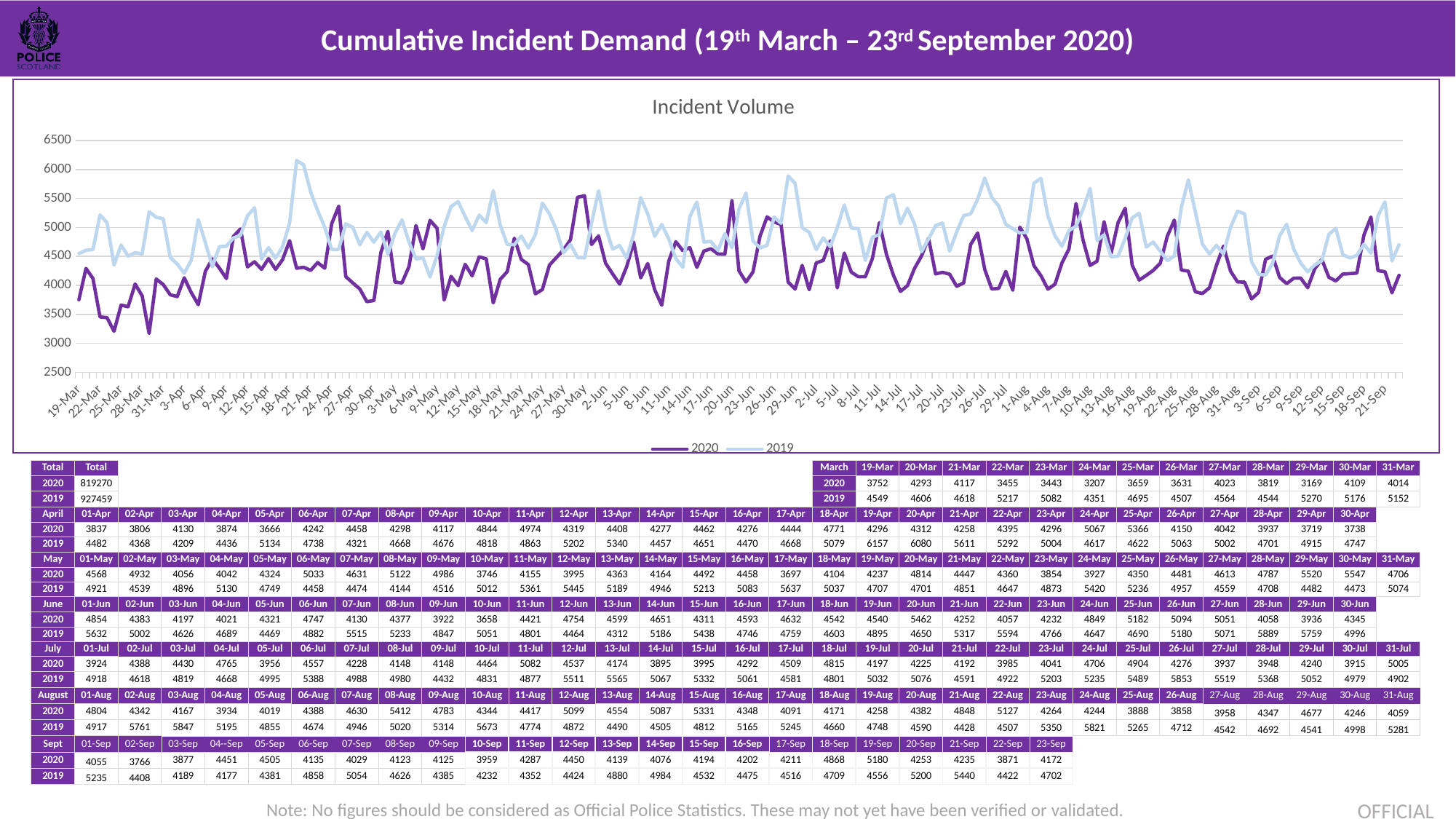
What is the 2020 incident volume on 19-Mar? 3752 Is the 2019 value on 19-Apr greater or less than 6000? greater What is the total incident volume for 2020? 819270 On 30-May, which series has the larger value, 2020 or 2019? 2020 What is the title of the chart? Incident Volume What is the difference between the 2019 value (4702) and the 2020 value (4172) on 23-Sep? 530 What is the difference between the 2019 total (927459) and the 2020 total (819270)? 108189 Is the 2020 value on 19-Mar greater or less than 4000? less What is the 2019 incident volume on 19-Apr? 6157 What kind of chart is shown on the slide? line chart On 19-Mar, which series has the larger value, 2020 or 2019? 2019 How many series does the chart legend list? 2